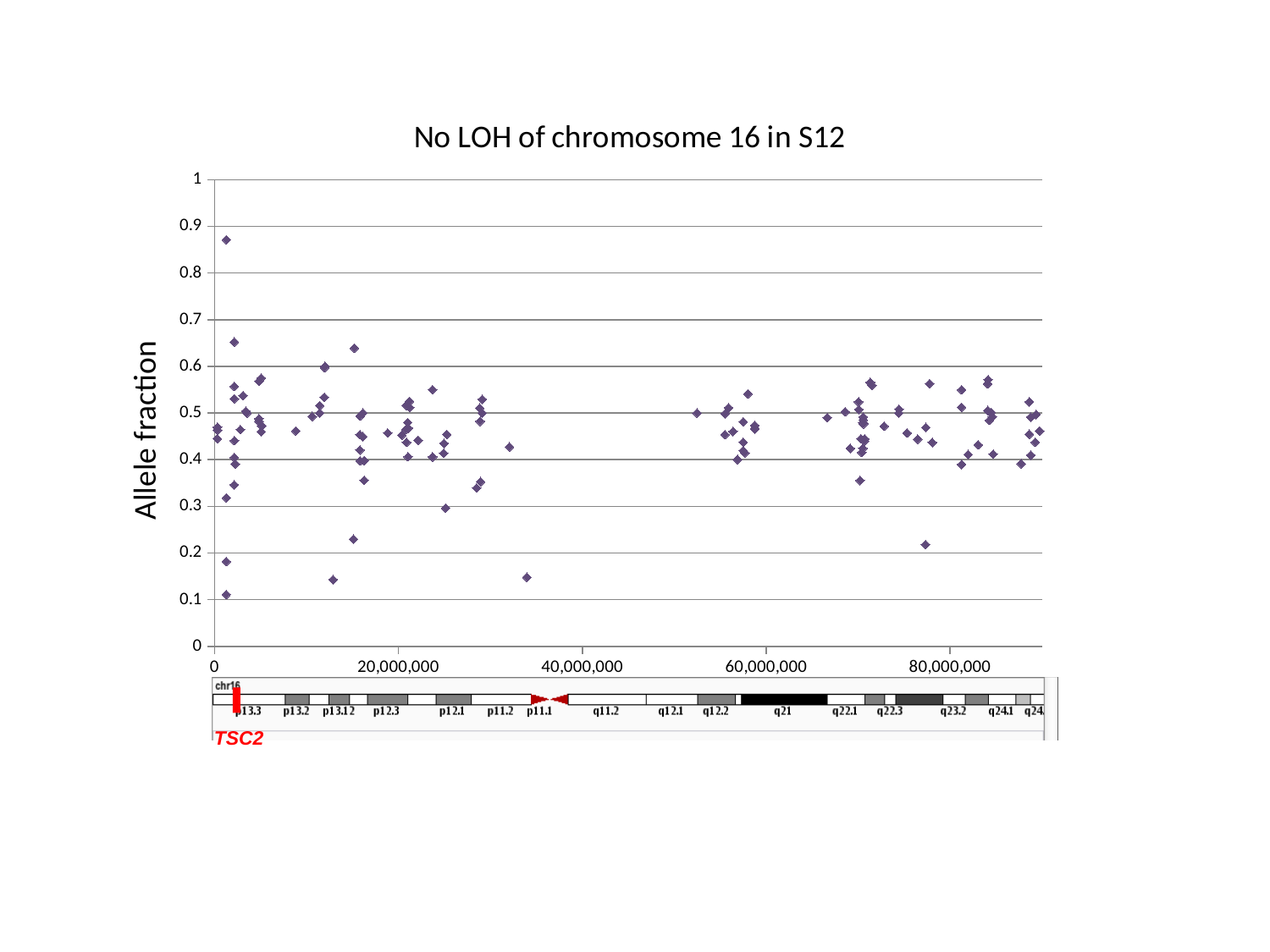
Are any points plotted between 40,000,000 and 50,000,000 on the x axis? No Is the highest plotted allele fraction greater or less than 0.8? greater What is the label on the y axis of the chart? Allele fraction Are the majority of the plotted points above or below 0.7 on the y axis? below What kind of chart is shown on the slide? scatter plot Is the isolated low point plotted near 78,000,000 on the x axis greater or less than 0.3? less What is the title of the chart? No LOH of chromosome 16 in S12